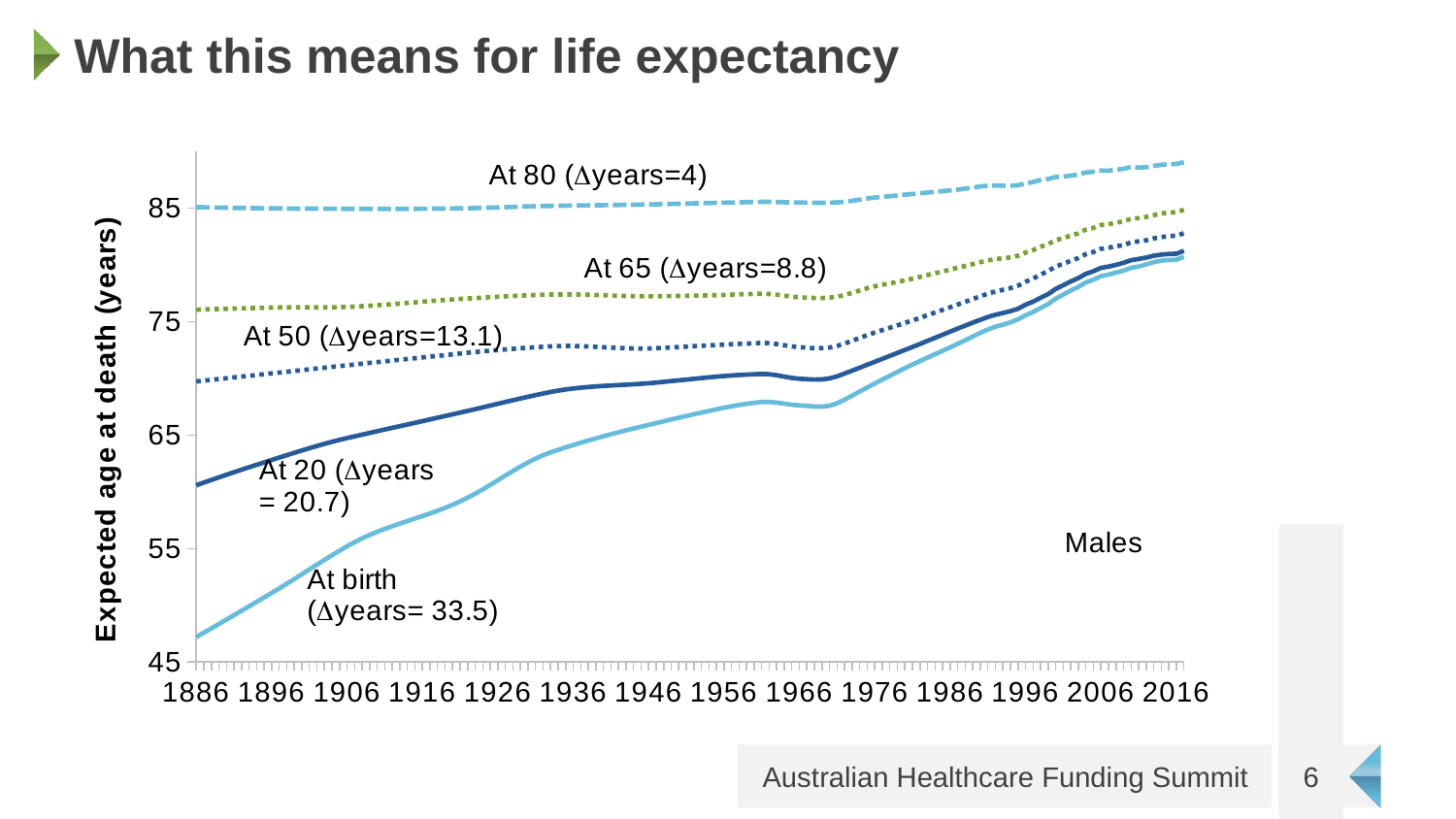
Does the 'At birth' line rise or fall from 1886 to 2016? rise What is the Δyears value given for the 'At birth' series? 33.5 Which series has the lowest expected age at death across the whole period? At birth What is the Δyears value given for the 'At 50' series? 13.1 Is the value for 'At birth' in 1886 greater or less than 50? less How many lines (series) are plotted on the chart? 5 Which series has the highest expected age at death across the whole period? At 80 What is the title of the vertical axis? Expected age at death (years) What is the Δyears value given for the 'At 20' series? 20.7 What is the difference between the Δyears values for 'At birth' and 'At 80'? 29.5 What is the Δyears value given for the 'At 80' series? 4 What kind of chart is shown on the slide? line chart